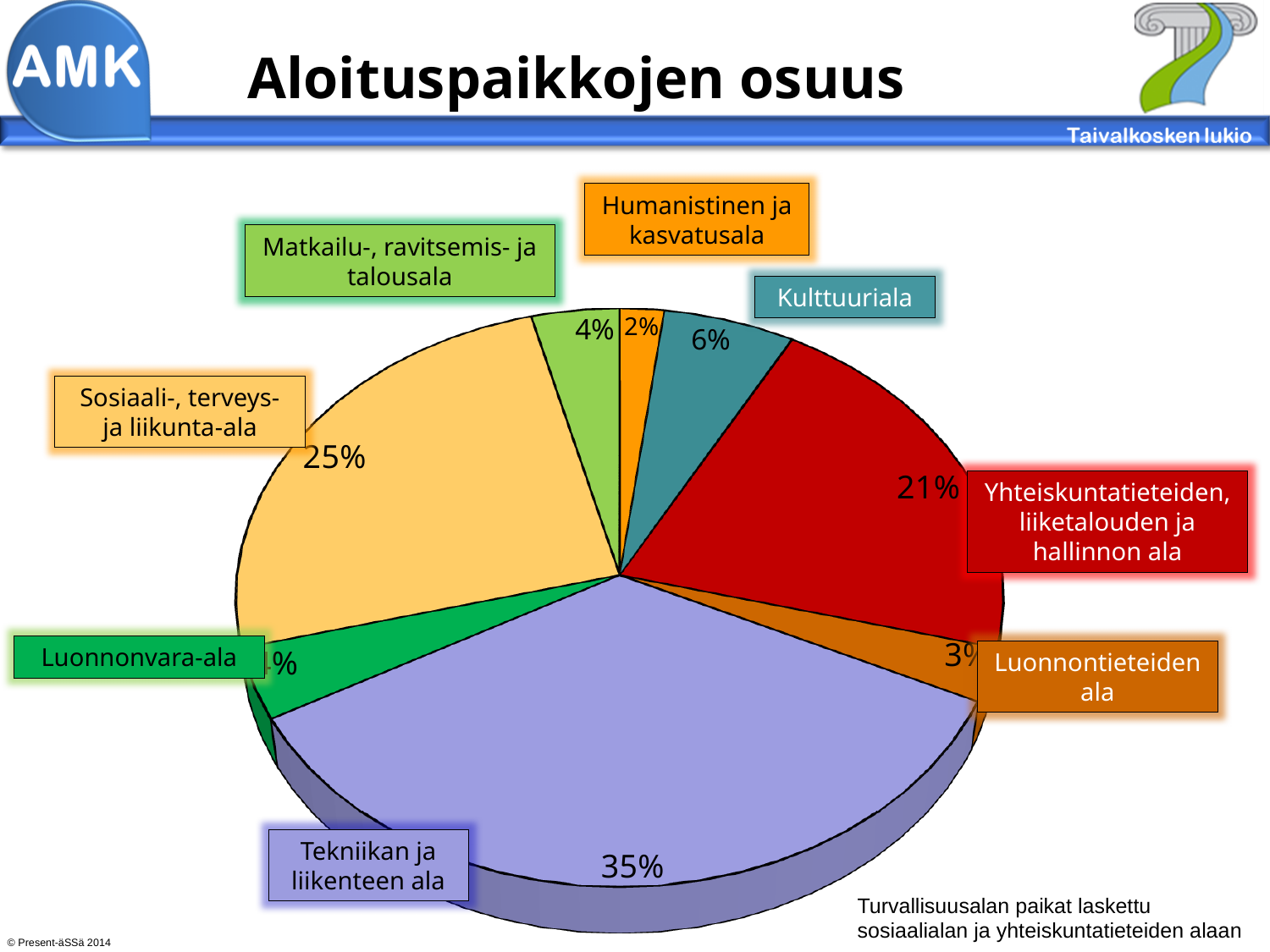
What kind of chart is shown on the slide? pie chart Which category has the smallest slice of the pie? Humanistinen ja kasvatusala Which is larger: Sosiaali-, terveys- ja liikunta-ala or Yhteiskuntatieteiden, liiketalouden ja hallinnon ala? Sosiaali-, terveys- ja liikunta-ala What is the value for Sosiaali-, terveys- ja liikunta-ala? 25% What is the difference in percentage points between Tekniikan ja liikenteen ala and Sosiaali-, terveys- ja liikunta-ala? 10 percentage points What is the value for Humanistinen ja kasvatusala? 2% What share of the pie does Tekniikan ja liikenteen ala have? 35% What is the value for Matkailu-, ravitsemis- ja talousala? 4% What is the value for Kulttuuriala? 6% What is the title of the chart? Aloituspaikkojen osuus What is the value for Yhteiskuntatieteiden, liiketalouden ja hallinnon ala? 21% Which category has the largest slice of the pie? Tekniikan ja liikenteen ala